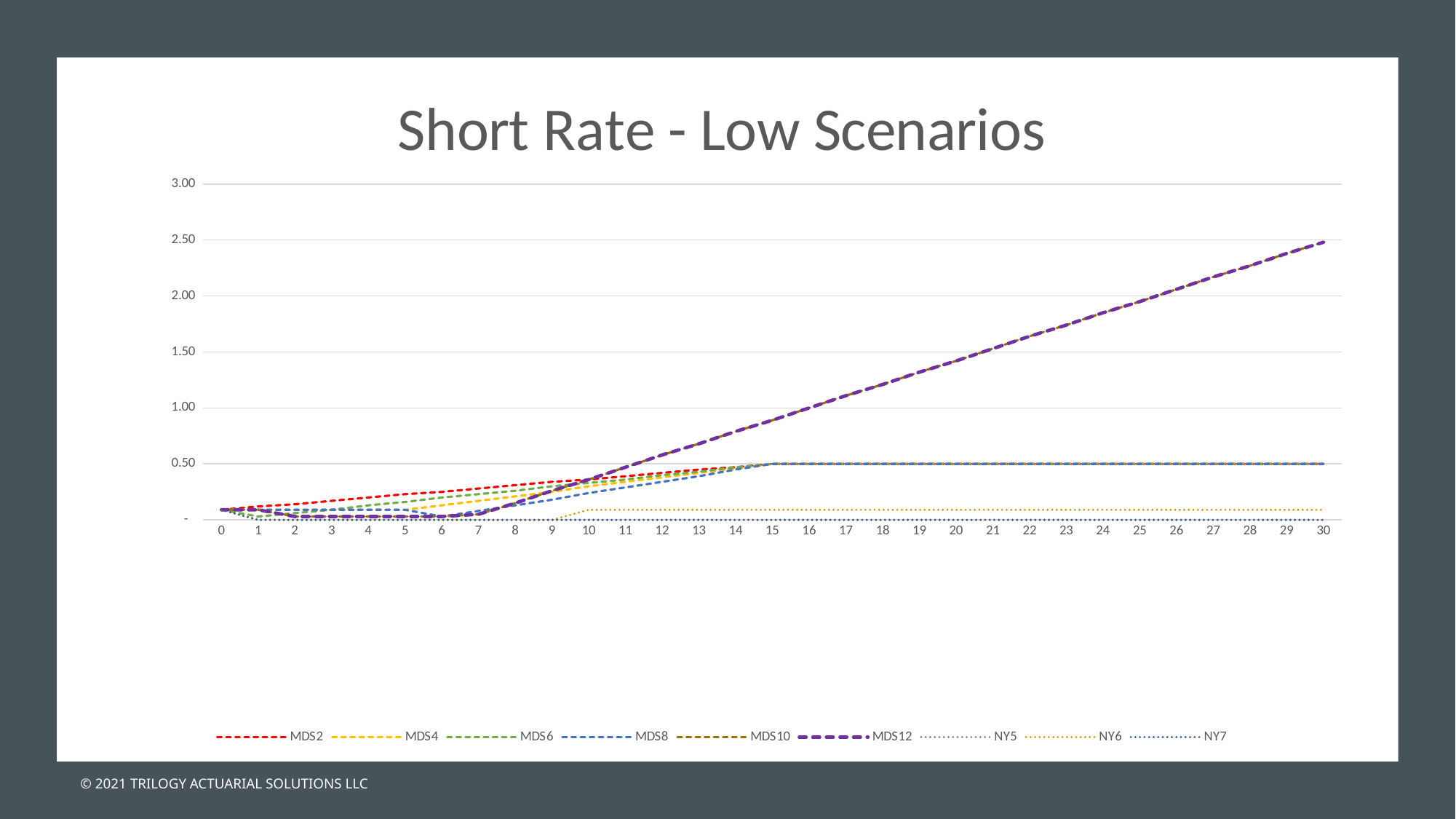
Is the value for MDS12 at 30 greater or less than 2.00? greater How many points are labelled along the x axis? 31 How many series does the legend list? 9 Does the MDS12 series rise or fall between 10 and 30 on the x axis? rise What kind of chart is shown on the slide? line chart Which is larger at 30, MDS12 or MDS2? MDS12 Is the value for MDS12 at 20 greater or less than 1.00? greater Is the value for MDS2 at 30 greater or less than 1.00? less Which series is listed first in the legend? MDS2 What is the title of the chart? Short Rate - Low Scenarios Which is larger at 30, MDS2 or NY7? MDS2